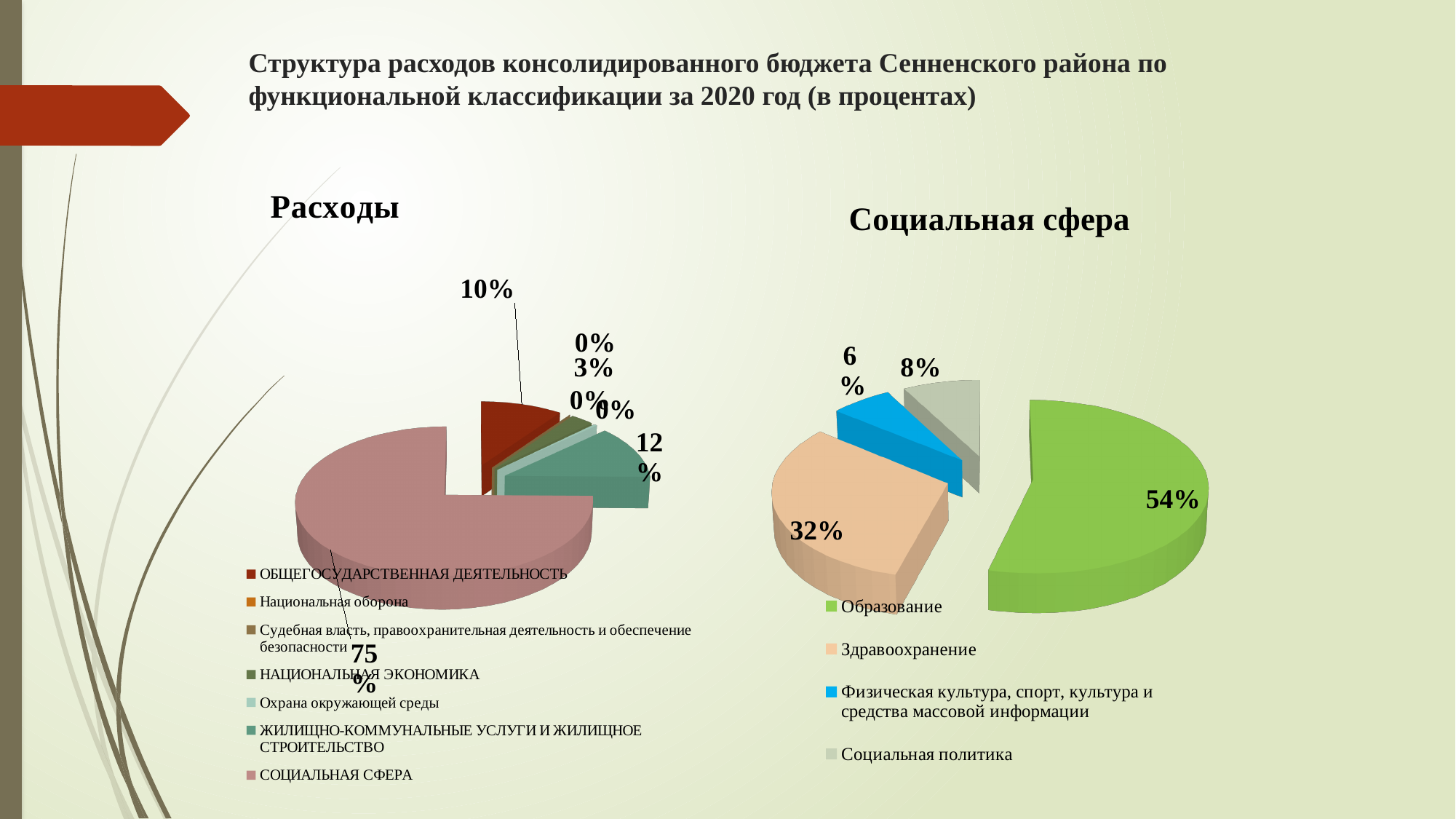
In the "Социальная сфера" chart, what share is labelled for Социальная политика? 8% In the "Социальная сфера" chart, what is the difference between the shares for Образование and Здравоохранение? 22% In the "Расходы" chart, what share is labelled for СОЦИАЛЬНАЯ СФЕРА? 75% In the "Социальная сфера" chart, how many categories does the legend list? 4 In the "Расходы" chart, what share is labelled for ЖИЛИЩНО-КОММУНАЛЬНЫЕ УСЛУГИ И ЖИЛИЩНОЕ СТРОИТЕЛЬСТВО? 12% What kind of chart is the "Расходы" chart? Pie chart In the "Социальная сфера" chart, which category has the smallest slice? Физическая культура, спорт, культура и средства массовой информации In the "Социальная сфера" chart, what share is labelled for Здравоохранение? 32% In the "Расходы" chart, how many categories does the legend list? 7 In the "Социальная сфера" chart, what share is labelled for Образование? 54% In the "Расходы" chart, what share is labelled for ОБЩЕГОСУДАРСТВЕННАЯ ДЕЯТЕЛЬНОСТЬ? 10% In the "Расходы" chart, which category has the largest slice? СОЦИАЛЬНАЯ СФЕРА